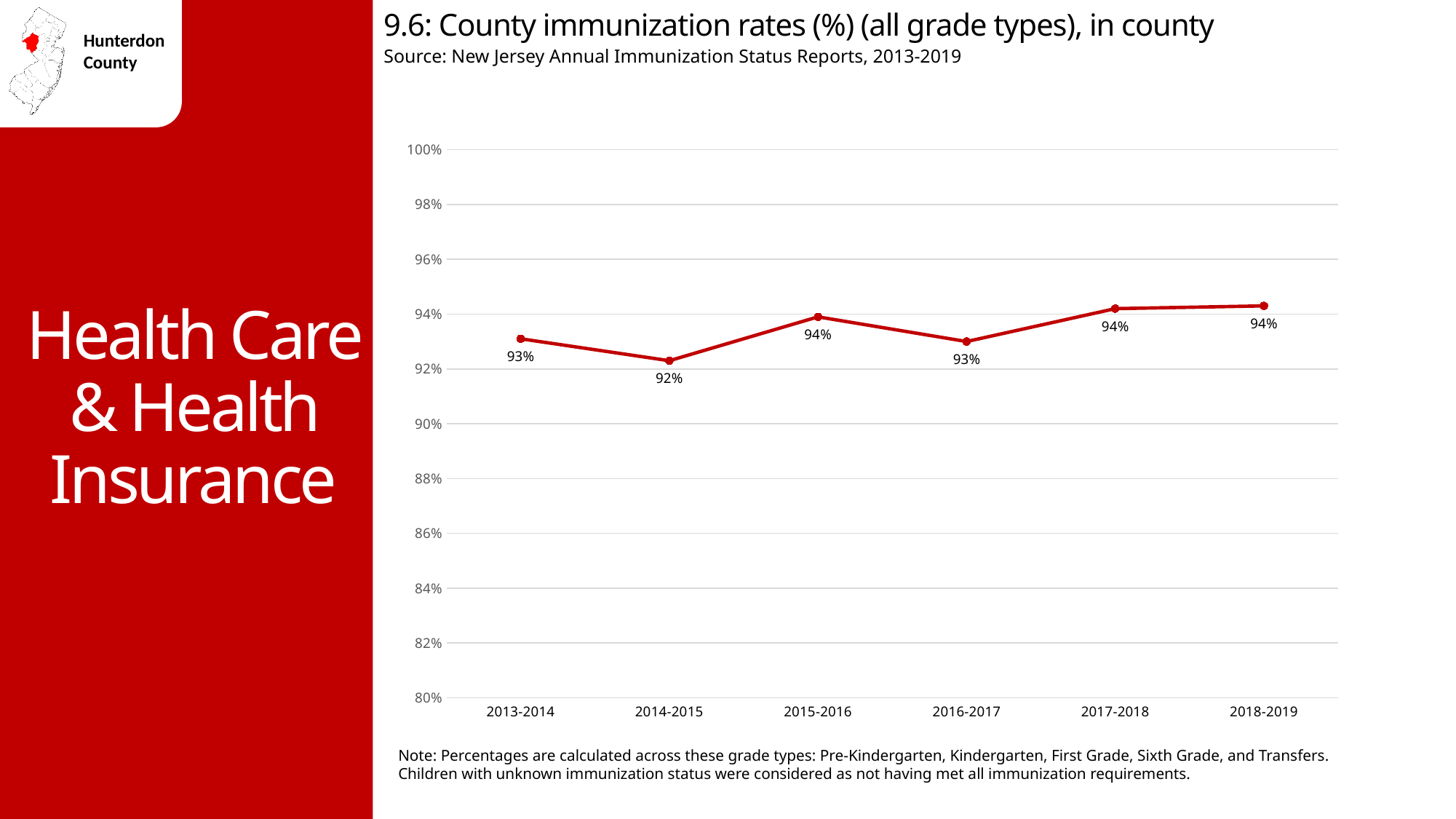
What was the county immunization rate for 2014-2015? 92% What is the source of the data shown in the chart? New Jersey Annual Immunization Status Reports, 2013-2019 How many school years are plotted on the chart? 6 What was the county immunization rate for 2013-2014? 93% Is the immunization rate for 2014-2015 greater or less than 94%? less What was the county immunization rate for 2018-2019? 94% What is the difference in percentage points between the immunization rate in 2015-2016 and in 2014-2015? 2 Did the immunization rate rise or fall from 2014-2015 to 2015-2016? rise Which year had a higher immunization rate, 2014-2015 or 2015-2016? 2015-2016 What kind of chart is shown on the slide? line chart Which school year had the lowest county immunization rate? 2014-2015 What was the county immunization rate for 2016-2017? 93%